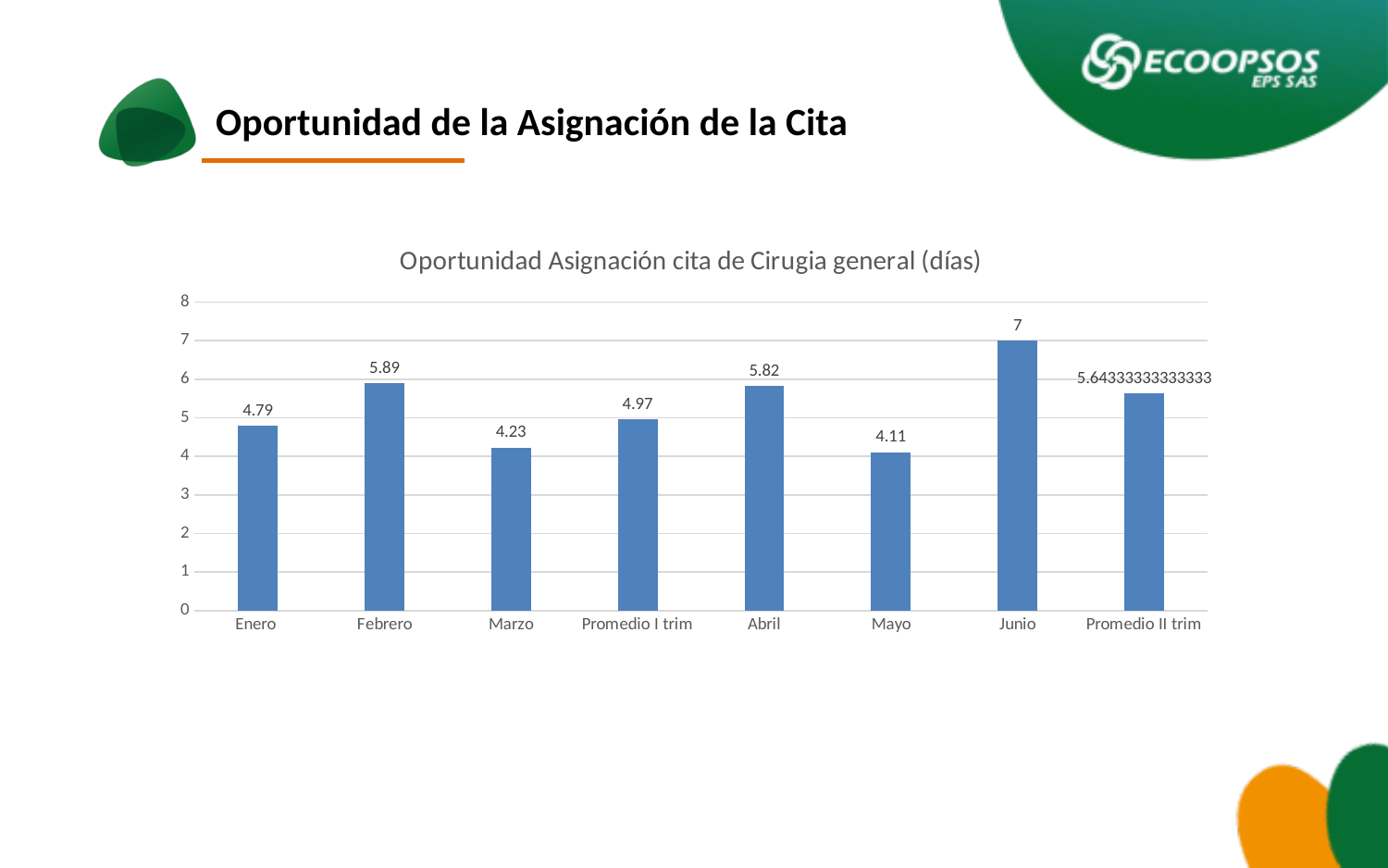
What is the value for Febrero? 5.89 Is the value for Marzo greater or less than 5? less Which category has the highest value? Junio What kind of chart is shown? bar chart Which category has the lowest value? Mayo What is the difference between the values for Junio and Mayo? 2.89 What is the title of the chart? Oportunidad Asignación cita de Cirugia general (días) Which is larger, the value for Febrero or the value for Abril? Febrero What is the value for Promedio II trim? 5.64333333333333 What is the value for Promedio I trim? 4.97 How many categories are shown on the x axis? 8 What is the value for Enero? 4.79